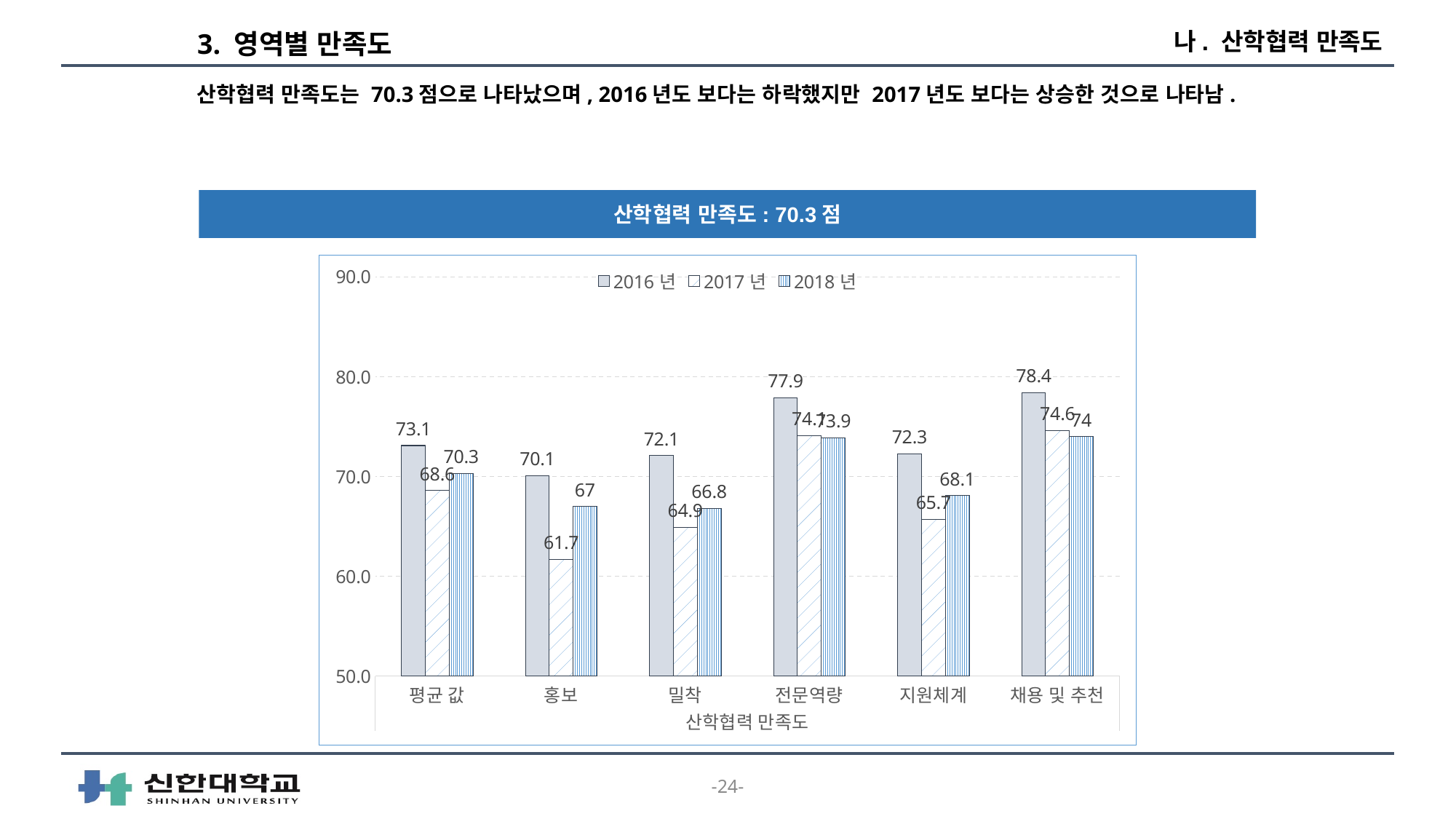
What is the 2016년 value for 전문역량? 77.9 How many categories are shown on the x axis? 6 Is the 2016년 value for 채용 및 추천 greater or less than 80.0? less Which is larger for 밀착: the 2017년 value or the 2018년 value? 2018년 What type of chart is shown on the slide? bar chart What is the 2018년 value for 평균 값? 70.3 What is the title shown in the blue banner above the chart? 산학협력 만족도 : 70.3 점 How many series does the legend list? 3 What is the difference between the 2016년 and 2018년 values for 지원체계? 4.2 Which category has the lowest 2017년 value? 홍보 Which category has the highest 2016년 value? 채용 및 추천 What is the 2017년 value for 홍보? 61.7